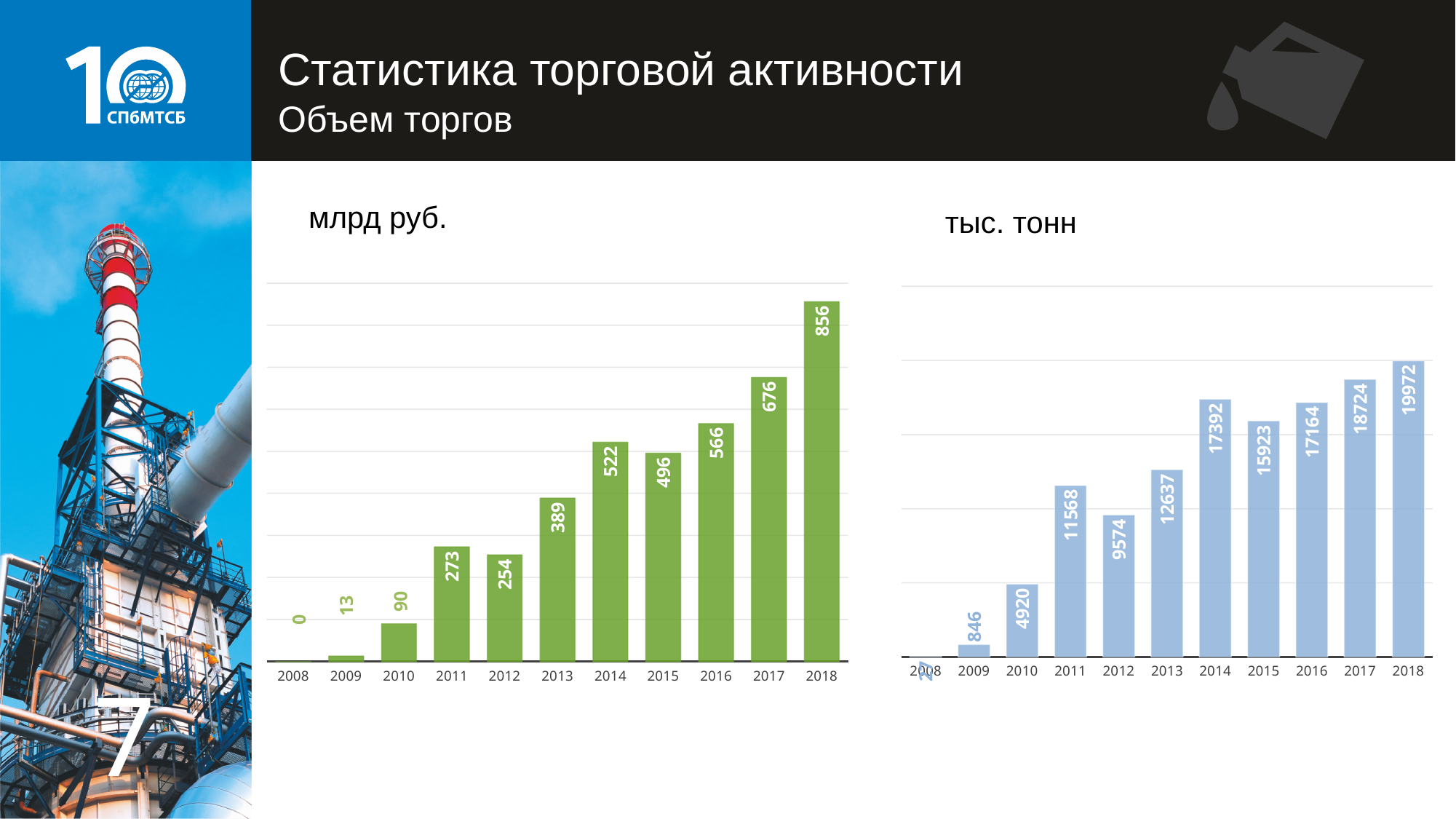
In the left chart (млрд руб.), which year has the lowest value? 2008 In the right chart (тыс. тонн), what is the difference between the values for 2018 and 2017? 1248 In the left chart (млрд руб.), what is the value for 2018? 856 How many years are shown on the x axis of the left chart (млрд руб.)? 11 In the left chart (млрд руб.), what is the value for 2013? 389 In the right chart (тыс. тонн), which year has the highest value? 2018 In the left chart (млрд руб.), which year has the highest value? 2018 In the left chart (млрд руб.), what is the difference between the values for 2018 and 2017? 180 In the right chart (тыс. тонн), what is the value for 2014? 17392 In the right chart (тыс. тонн), what is the value for 2010? 4920 In the left chart (млрд руб.), which is larger, the value for 2011 or the value for 2012? 2011 In the right chart (тыс. тонн), which is larger, the value for 2014 or the value for 2015? 2014